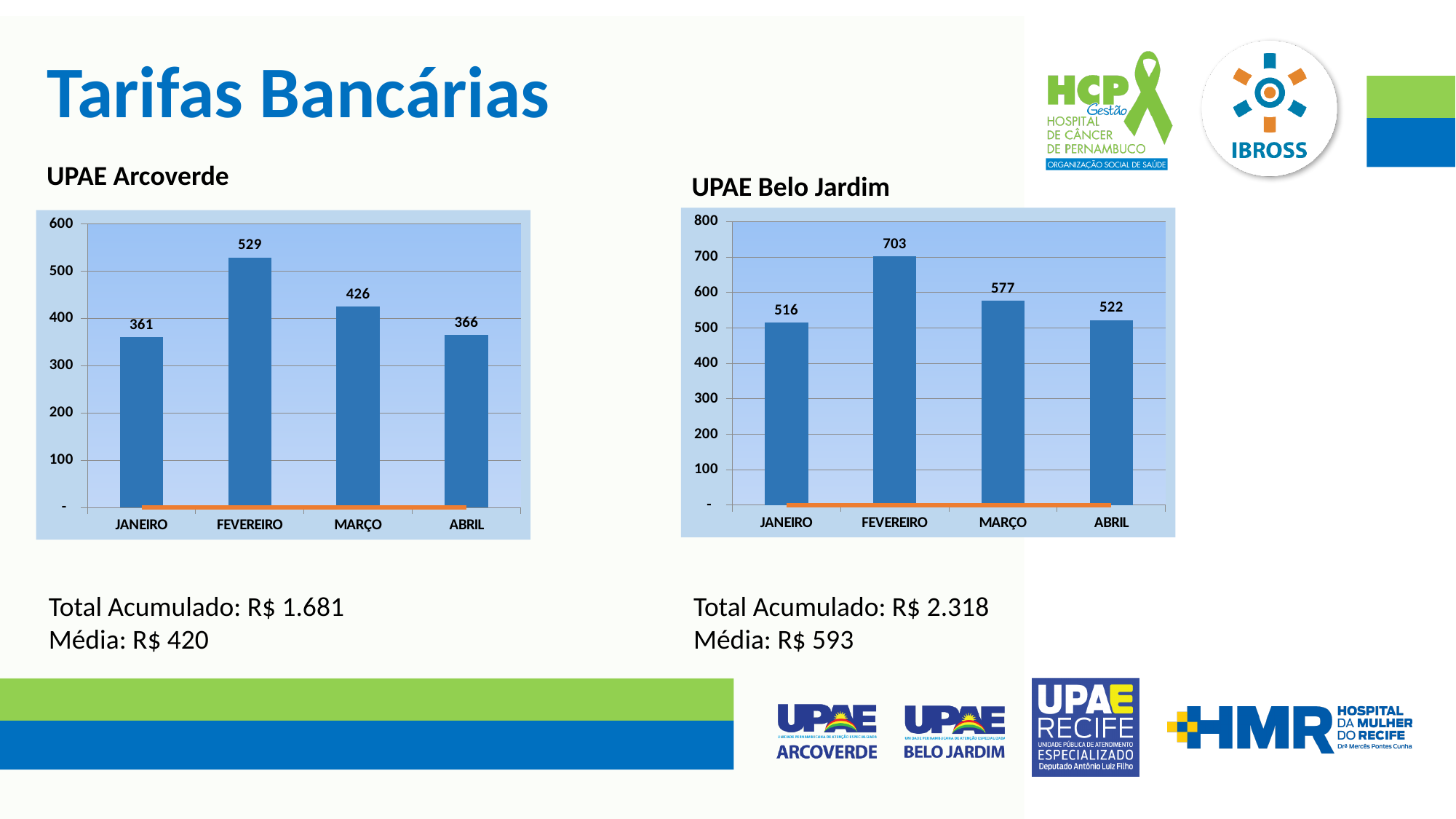
In the UPAE Arcoverde chart, what is the difference between the values for FEVEREIRO and ABRIL? 163 What kind of chart is the UPAE Arcoverde chart? Bar chart In the UPAE Arcoverde chart, what is the value for FEVEREIRO? 529 What is the title of the chart on the right side of the slide? UPAE Belo Jardim In the UPAE Arcoverde chart, does the value rise or fall from FEVEREIRO to MARÇO? Fall In the UPAE Arcoverde chart, is the value for MARÇO greater or less than 400? greater In the UPAE Belo Jardim chart, which is larger, the value for JANEIRO or the value for ABRIL? ABRIL How many months are shown in the UPAE Belo Jardim chart? 4 In the UPAE Belo Jardim chart, what is the value for MARÇO? 577 In the UPAE Belo Jardim chart, which month has the highest value? FEVEREIRO In the UPAE Belo Jardim chart, what is the difference between the values for FEVEREIRO and JANEIRO? 187 In the UPAE Arcoverde chart, which month has the lowest value? JANEIRO